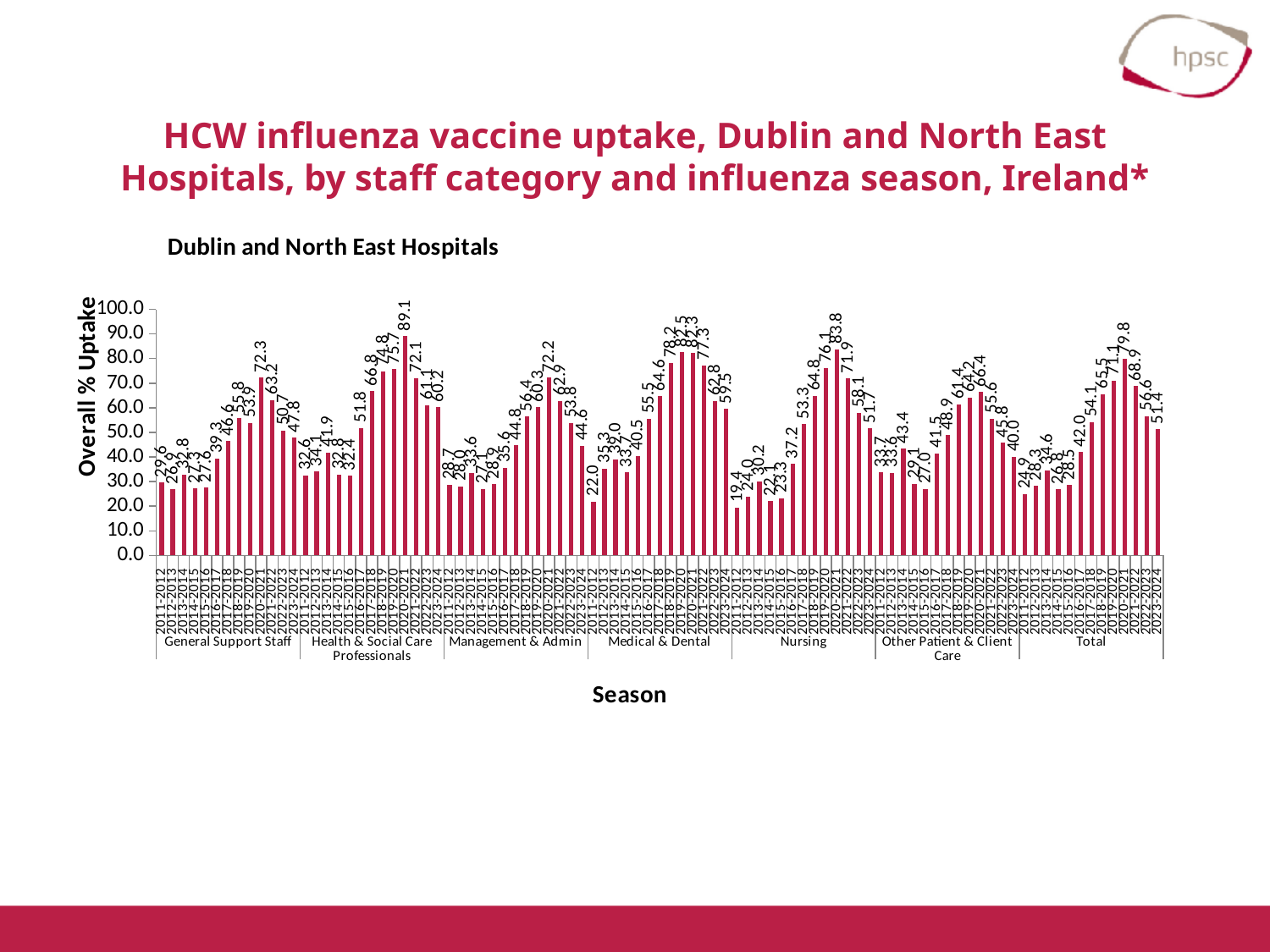
Which staff category and season has the lowest Overall % Uptake on the chart? Nursing, 2011-2012 Which staff category and season has the highest Overall % Uptake on the chart? Health & Social Care Professionals, 2020-2021 What is the label of the y axis? Overall % Uptake What is the Total Overall % Uptake in the 2020-2021 season? 79.8 What is the Overall % Uptake for Health & Social Care Professionals in the 2020-2021 season? 89.1 What is the Overall % Uptake for Nursing in the 2020-2021 season? 83.8 What type of chart is shown on the slide? Bar chart How many staff categories are shown along the x axis? 7 Is the Overall % Uptake for Medical & Dental in 2011-2012 greater or less than 30.0? less What is the Total Overall % Uptake in the 2023-2024 season? 51.4 What is the difference between the Total Overall % Uptake in 2020-2021 and in 2023-2024? 28.4 Which is larger: the 2020-2021 uptake for Nursing or for General Support Staff? Nursing